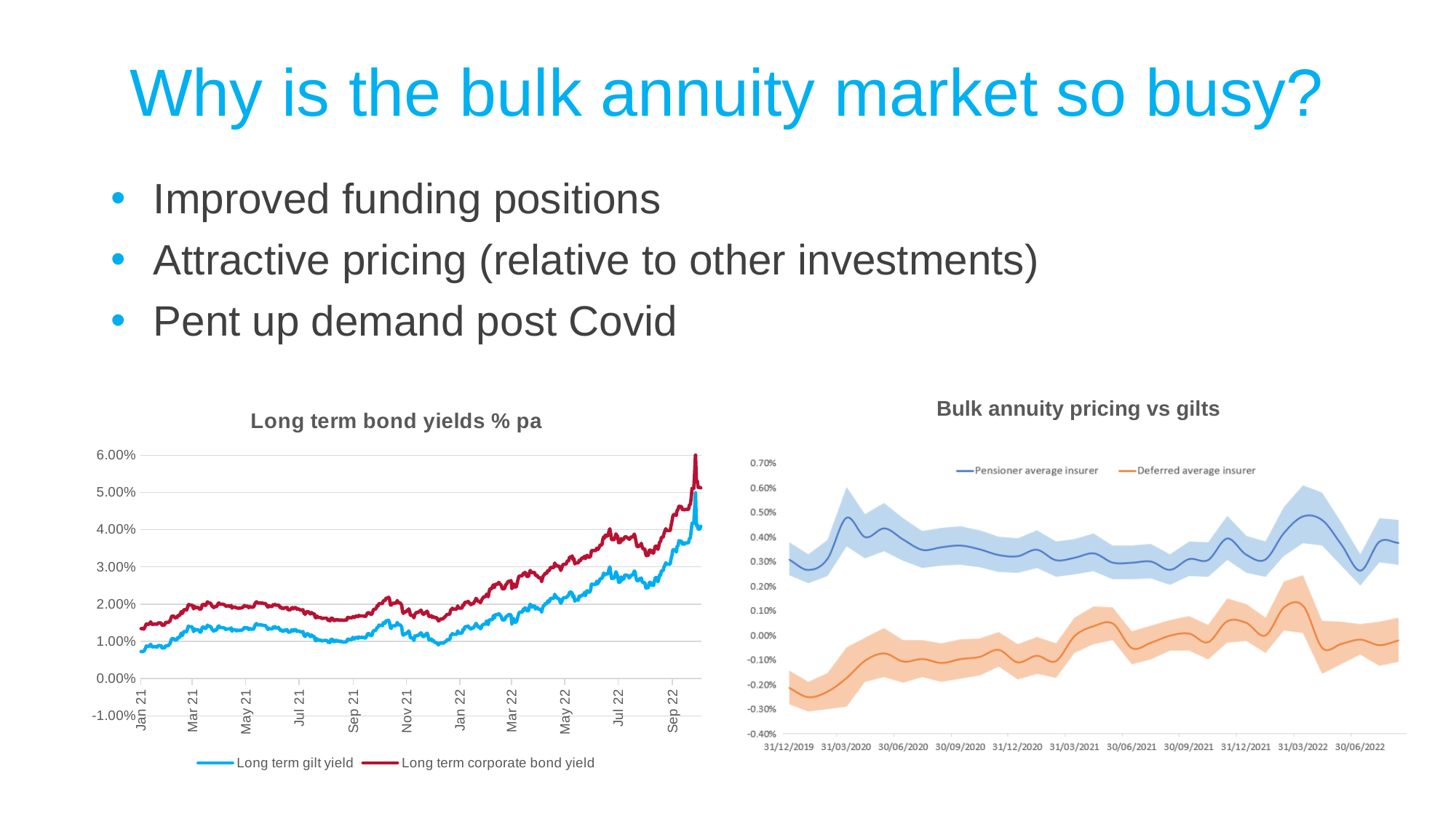
In the 'Bulk annuity pricing vs gilts' chart, is the Deferred average insurer value at 31/12/2019 greater or less than 0.00%? less In the 'Bulk annuity pricing vs gilts' chart, which series is higher throughout: Pensioner average insurer or Deferred average insurer? Pensioner average insurer In the 'Long term bond yields % pa' chart, which series is higher throughout the period: Long term gilt yield or Long term corporate bond yield? Long term corporate bond yield In the 'Bulk annuity pricing vs gilts' chart, is the Pensioner average insurer value at 31/03/2022 greater or less than 0.40%? greater What kind of chart is the 'Long term bond yields % pa' chart? Line chart In the 'Long term bond yields % pa' chart, which series is plotted in red? Long term corporate bond yield In the 'Long term bond yields % pa' chart, do the yields overall rise or fall from Jan 21 to Sep 22? Rise How many series does the legend of the 'Long term bond yields % pa' chart list? 2 In the 'Long term bond yields % pa' chart, is the peak of the Long term corporate bond yield greater or less than 5.00%? greater How many series does the legend of the 'Bulk annuity pricing vs gilts' chart list? 2 What kind of chart is the 'Bulk annuity pricing vs gilts' chart? Line chart